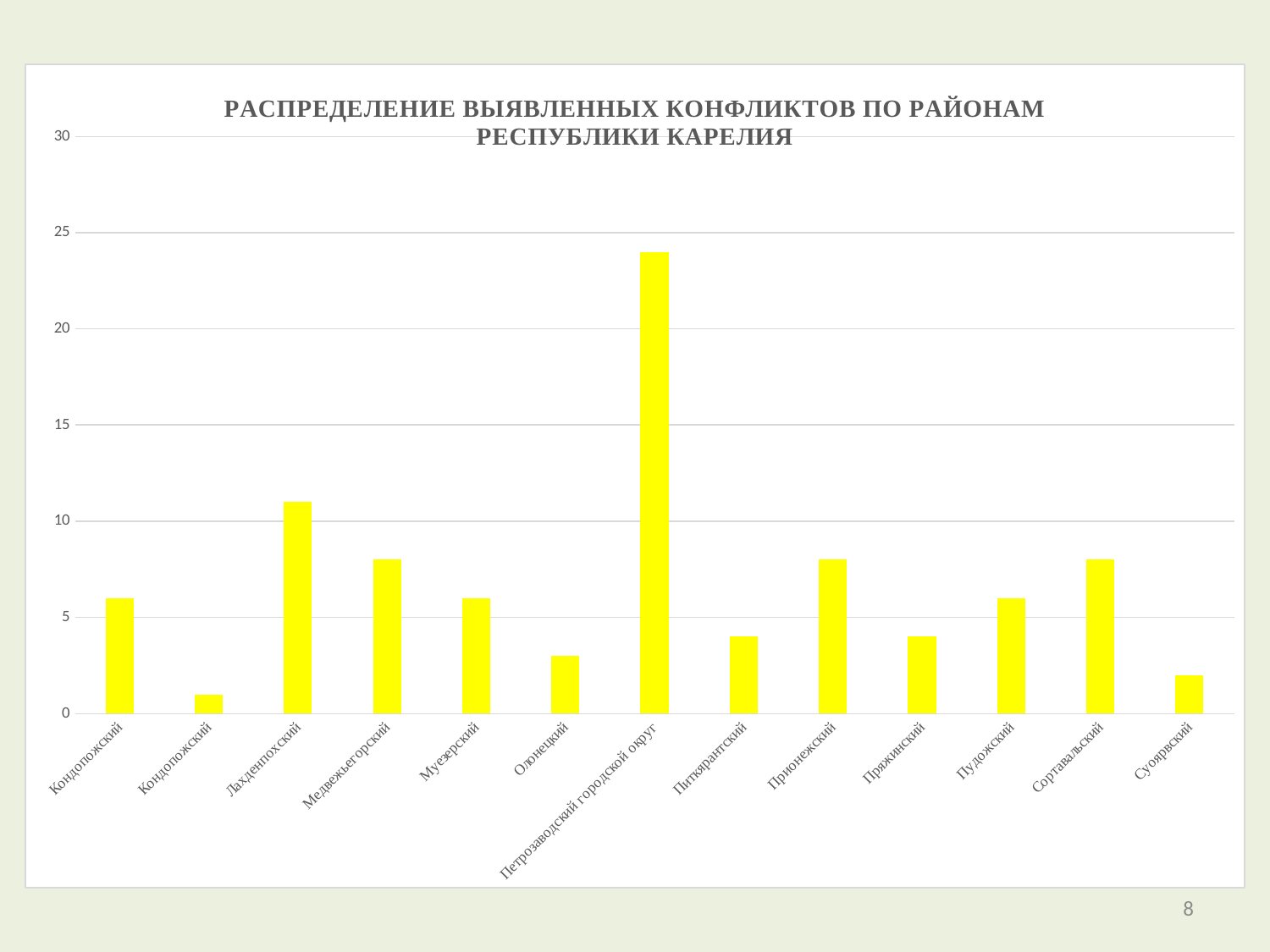
What colour are the bars in the chart? yellow Is the value for Суоярвский greater or less than 5? less What is the title of the chart? РАСПРЕДЕЛЕНИЕ ВЫЯВЛЕННЫХ КОНФЛИКТОВ ПО РАЙОНАМ РЕСПУБЛИКИ КАРЕЛИЯ Which is larger, the value for Прионежский or the value for Питкярантский? Прионежский How many categories (districts) are shown on the x axis? 13 Which is larger, the value for Лахденпохский or the value for Медвежьегорский? Лахденпохский Which district has the highest number of identified conflicts? Петрозаводский городской округ Is the value for Сортавальский greater or less than 5? greater Is the value for Петрозаводский городской округ greater or less than 20? greater What kind of chart is shown on the slide? bar chart